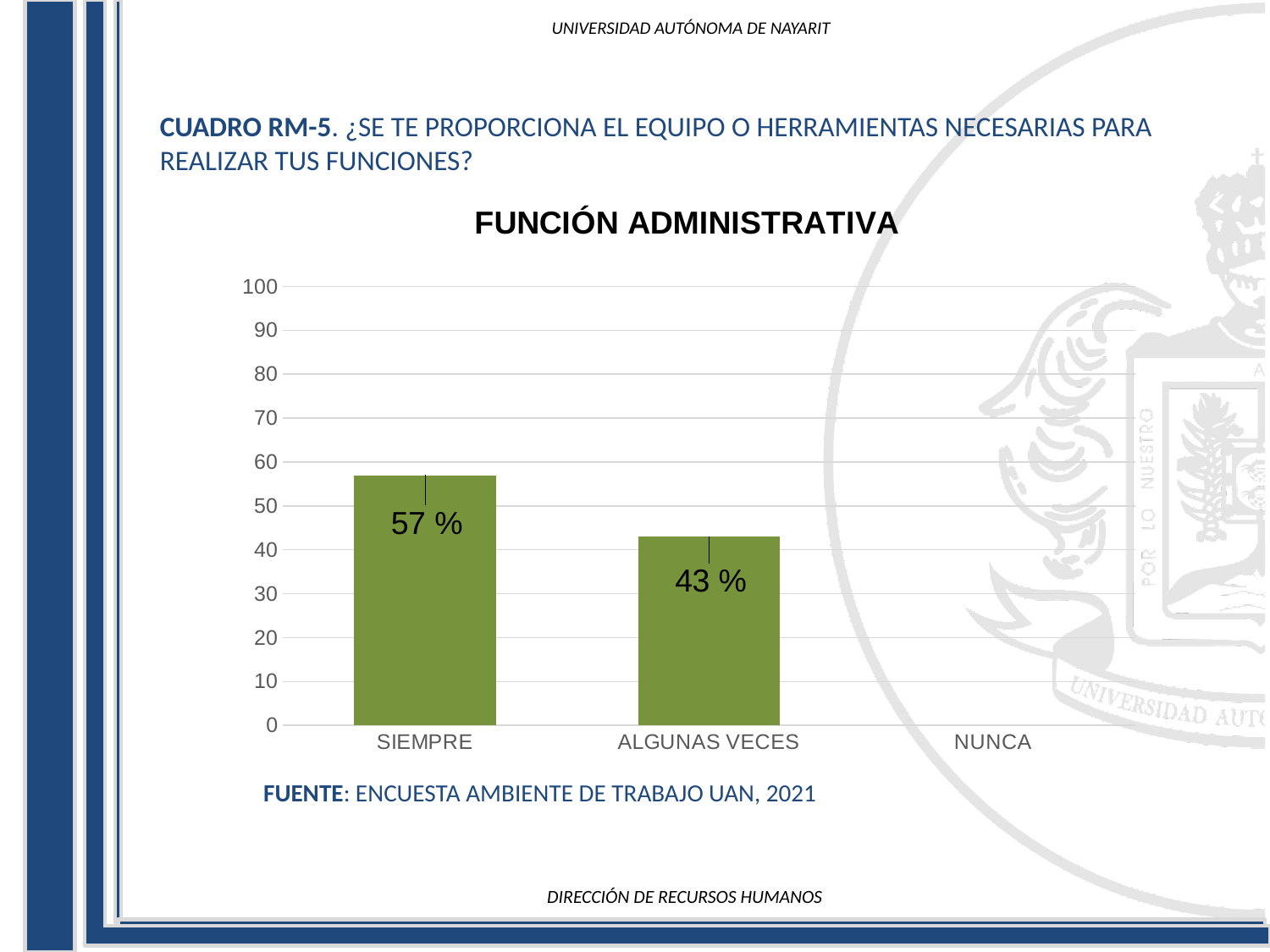
How many categories are shown on the x axis? 3 What is the title of the chart? FUNCIÓN ADMINISTRATIVA What kind of chart is shown? bar chart Which category has the highest value? SIEMPRE What is the value for SIEMPRE? 57 % Is the value for ALGUNAS VECES greater or less than 50? less Which is larger, the value for SIEMPRE or the value for ALGUNAS VECES? SIEMPRE What is the value for ALGUNAS VECES? 43 % What is the difference between the values for SIEMPRE and ALGUNAS VECES? 14 % Is the value for SIEMPRE greater or less than 50? greater Do the values rise or fall from left to right along the x axis? fall